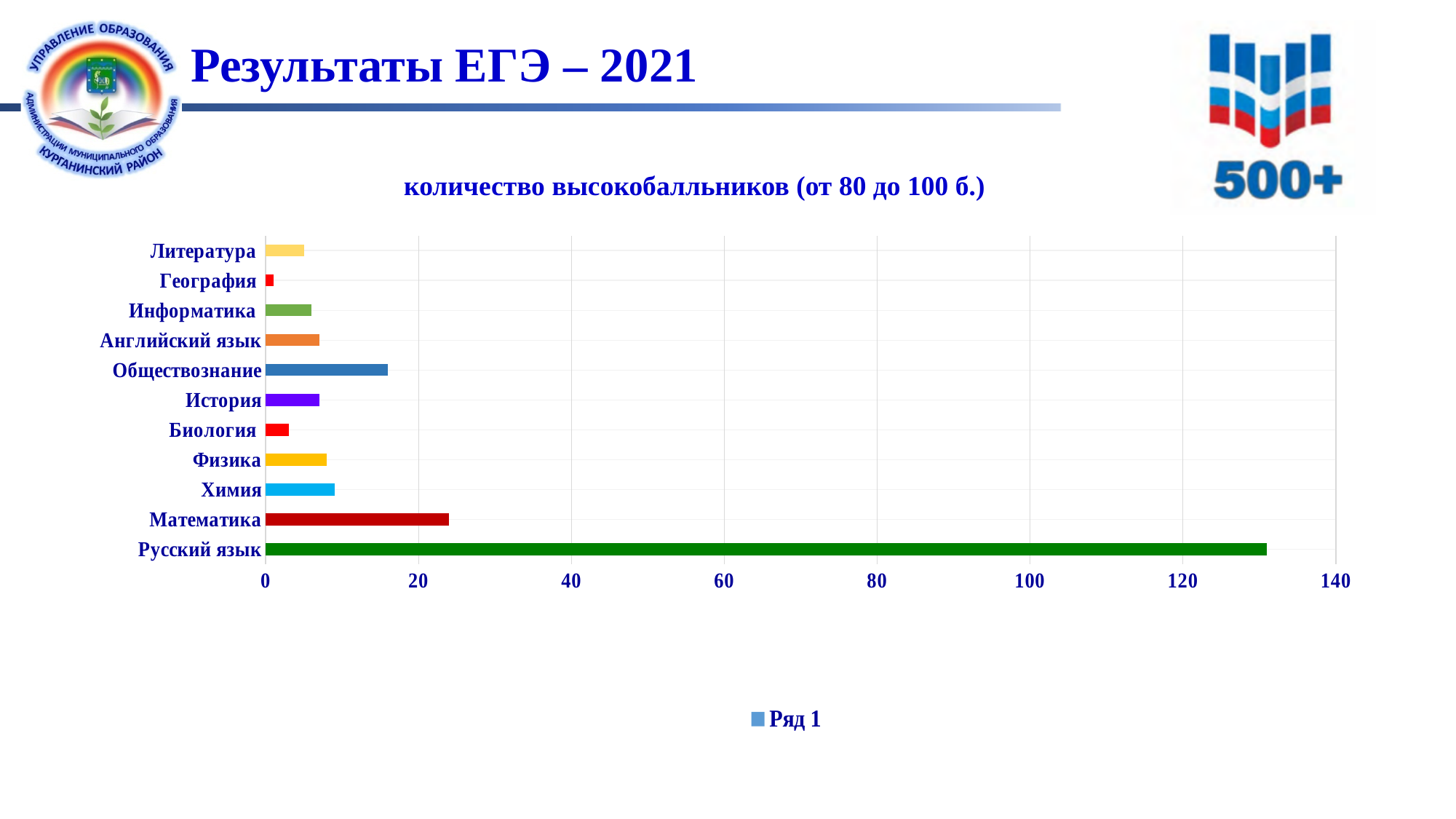
Is the value for Обществознание greater or less than 20? less What is the title of the chart? количество высокобалльников (от 80 до 100 б.) How many series does the legend list? 1 What kind of chart is shown on the slide? bar chart Which subject has the lowest number of high scorers in the chart? География Which has a larger value, Математика or Обществознание? Математика Which has a larger value, Химия or Биология? Химия Is the value for Русский язык greater or less than 120? greater Which subject has the highest number of high scorers in the chart? Русский язык How many subjects (categories) are shown in the chart? 11 What is the name of the series shown in the legend? Ряд 1 Is the value for Математика greater or less than 20? greater